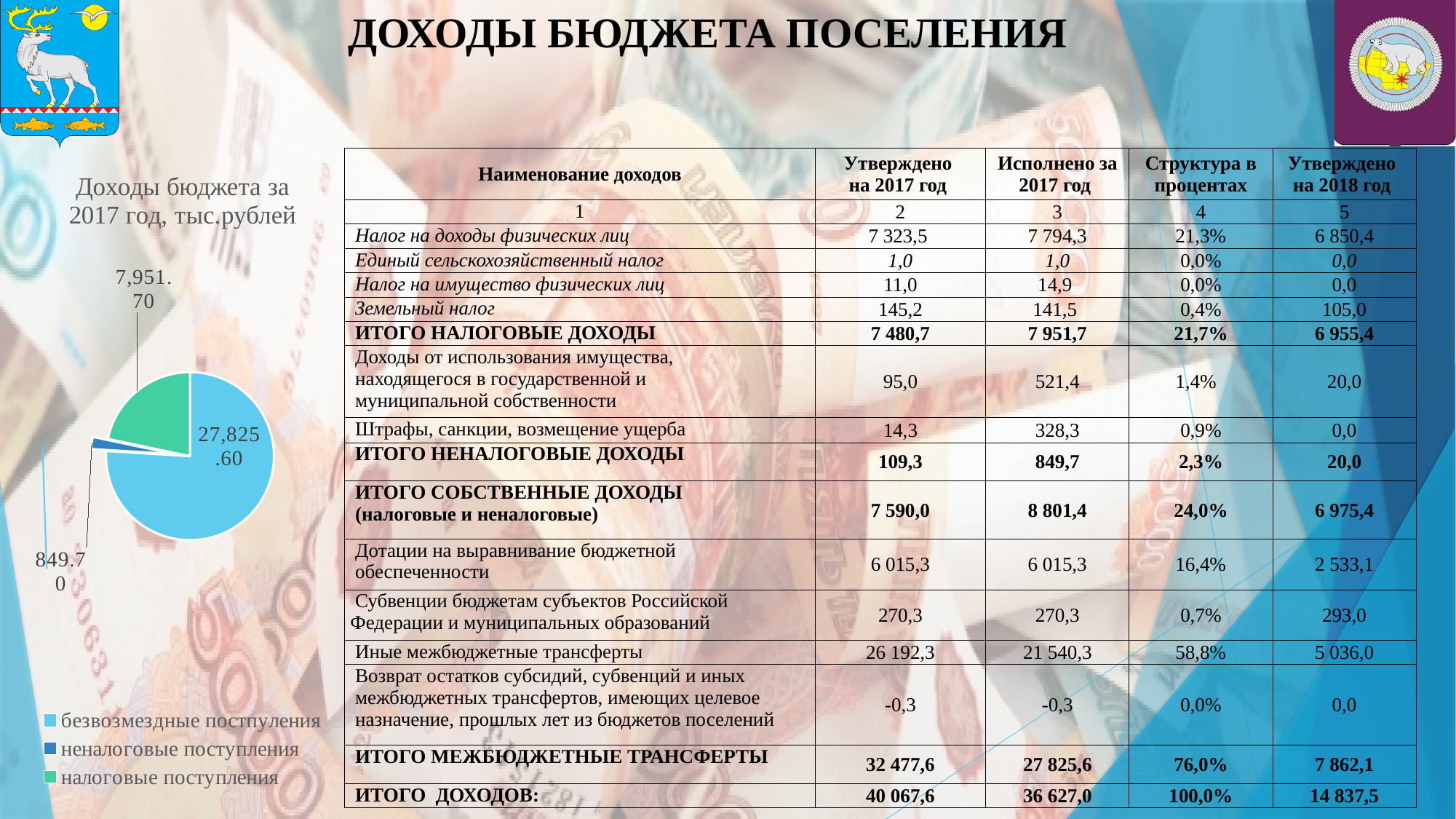
How many entries does the pie chart's legend list? 3 What is the title of the pie chart? Доходы бюджета за 2017 год, тыс.рублей How many slices does the pie chart have? 3 In the pie chart, what is the difference between безвозмездные поступления and налоговые поступления? 19,873.90 What is the value for налоговые поступления in the pie chart? 7,951.70 What is the value for неналоговые поступления in the pie chart? 849.70 What kind of chart is shown on the left of the slide? pie chart What is the value for безвозмездные поступления in the pie chart? 27,825.60 In the pie chart, which is larger: налоговые поступления or неналоговые поступления? налоговые поступления Which category has the smallest slice in the pie chart? неналоговые поступления Which category has the largest slice in the pie chart? безвозмездные поступления What colour is the slice for безвозмездные поступления in the pie chart? light blue